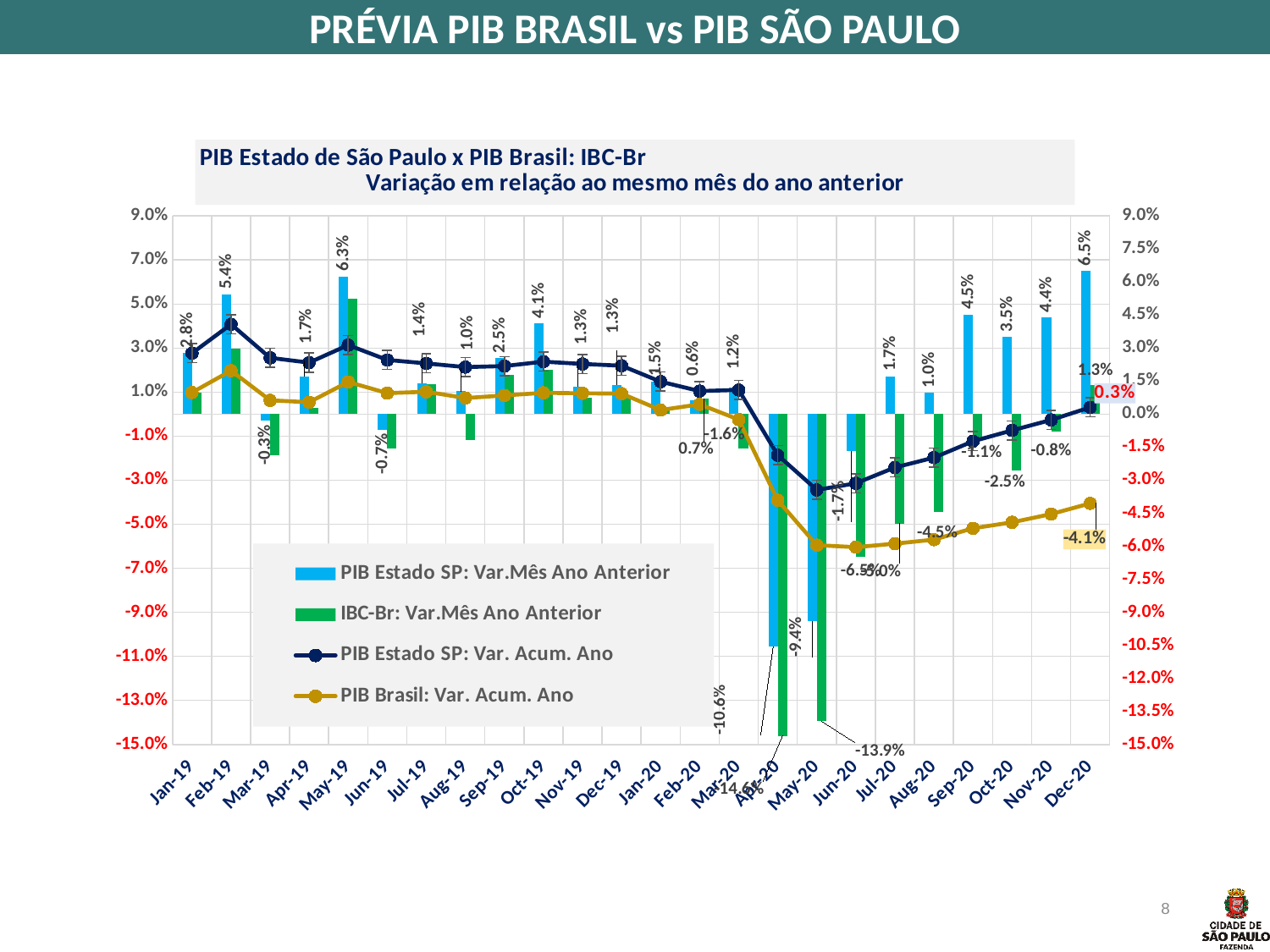
Which is larger for PIB Estado SP: Var.Mês Ano Anterior, Feb-19 or May-19? May-19 What is the value of PIB Estado SP: Var.Mês Ano Anterior for Dec-20? 6.5% Which month has the lowest value for PIB Estado SP: Var.Mês Ano Anterior? Apr-20 How many months are shown along the x axis? 24 What is the highlighted value of PIB Brasil: Var. Acum. Ano at Dec-20? -4.1% What is the value of PIB Estado SP: Var.Mês Ano Anterior for Feb-19? 5.4% What is the value of PIB Estado SP: Var.Mês Ano Anterior for Apr-20? -10.6% How many series does the legend list? 4 Is the IBC-Br: Var.Mês Ano Anterior value for Apr-20 greater or less than -13.0%? less Which month has the highest value for PIB Estado SP: Var.Mês Ano Anterior? Dec-20 What kind of chart is shown on the slide? Combined bar and line chart What is the difference between the PIB Estado SP: Var.Mês Ano Anterior values for Dec-20 and Nov-20? 2.1 percentage points